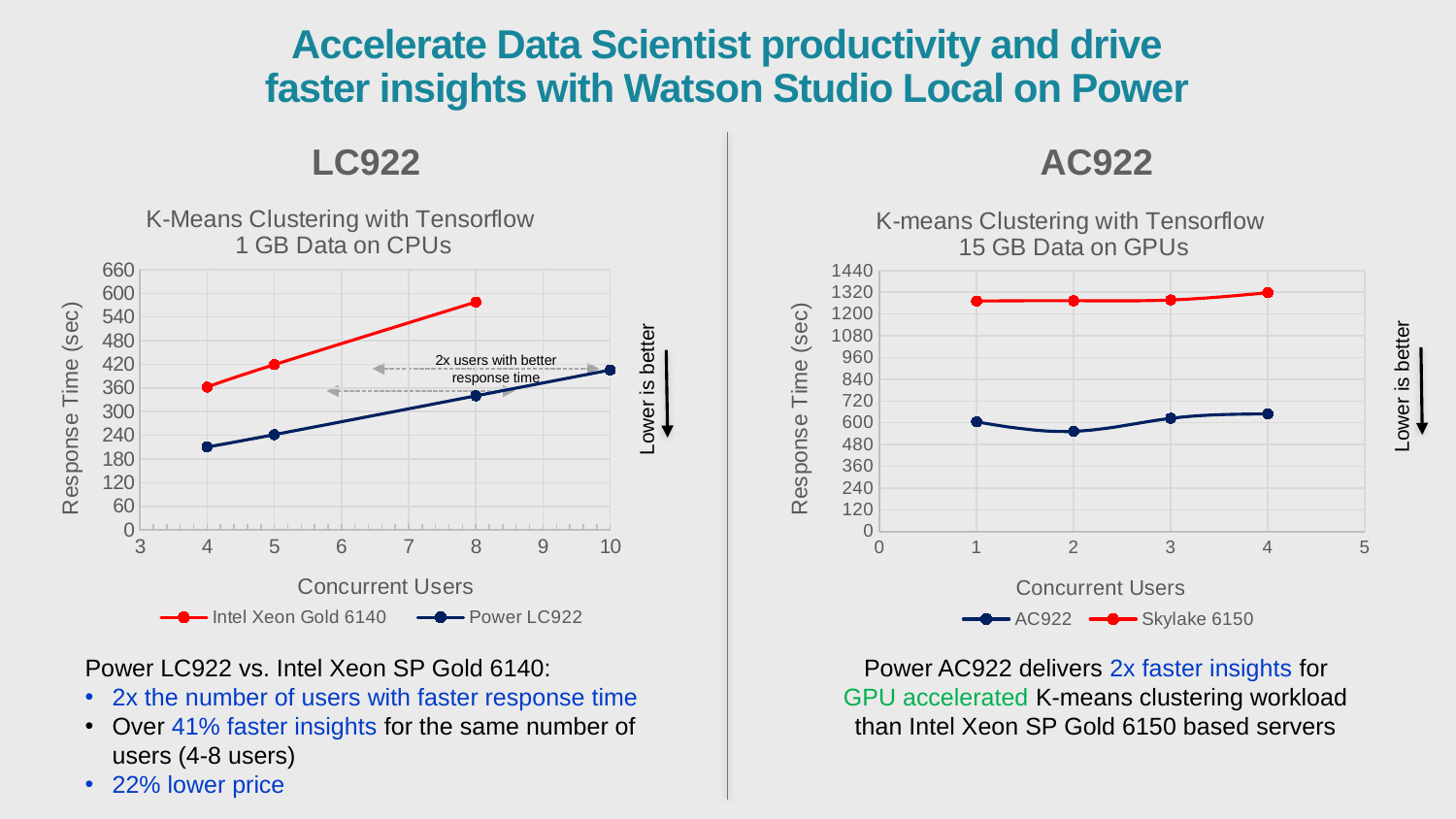
In the AC922 chart on the right, is the response time for Skylake 6150 at 1 concurrent user greater or less than 1200? greater In the LC922 chart on the left, at 8 concurrent users, which series has the higher response time, Intel Xeon Gold 6140 or Power LC922? Intel Xeon Gold 6140 In the LC922 chart on the left, how many data points are plotted for the Intel Xeon Gold 6140 series? 3 What kind of chart is the LC922 chart on the left? line chart In the LC922 chart on the left, is the response time for Power LC922 at 4 concurrent users greater or less than 240? less In the LC922 chart on the left, is the response time for Intel Xeon Gold 6140 at 8 concurrent users greater or less than 480? greater In the LC922 chart on the left, how many data points are plotted for the Power LC922 series? 4 In the LC922 chart on the left, does the response time for Intel Xeon Gold 6140 rise or fall as the number of concurrent users increases? rise In the AC922 chart on the right, at 4 concurrent users, which series has the higher response time, AC922 or Skylake 6150? Skylake 6150 What is the title of the chart on the right? K-means Clustering with Tensorflow 15 GB Data on GPUs How many series does the legend of the AC922 chart on the right list? 2